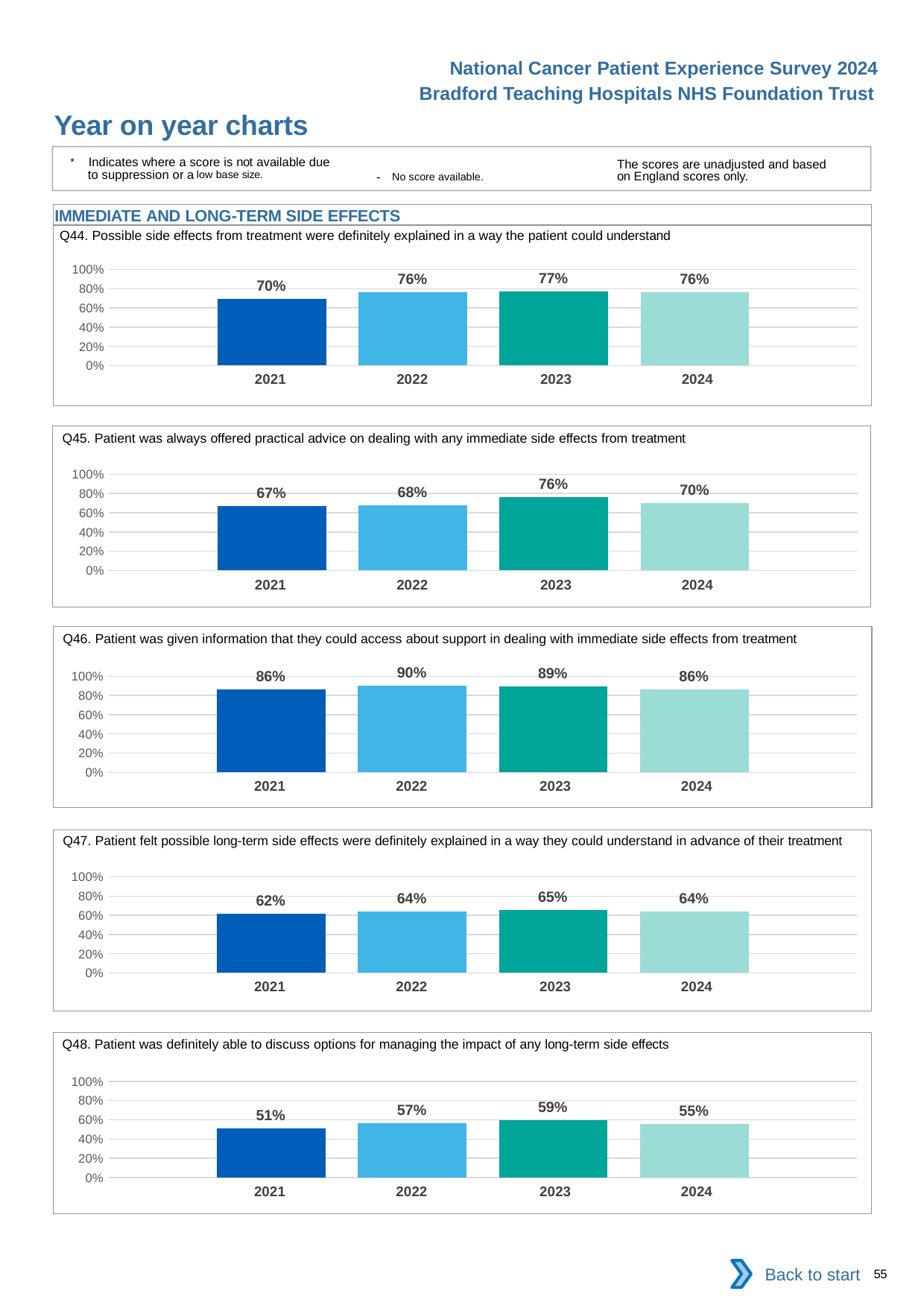
In the Q48 chart, what is the difference between the 2023 and 2021 values? 8% In the Q48 chart, is the value for 2024 greater or less than 60%? less In the Q44 chart, which year has the highest value? 2023 What kind of chart is the Q44 chart? Bar chart In the Q48 chart, what is the value for 2021? 51% In the Q46 chart, which is larger, the value for 2022 or the value for 2024? 2022 In the Q47 chart, how many years are plotted? 4 In the Q46 chart, what is the value for 2022? 90% In the Q47 chart, what is the value for 2023? 65% In the Q45 chart, what is the difference between the 2023 and 2024 values? 6% In the Q45 chart, which year has the lowest value? 2021 In the Q44 chart, what is the value for 2021? 70%